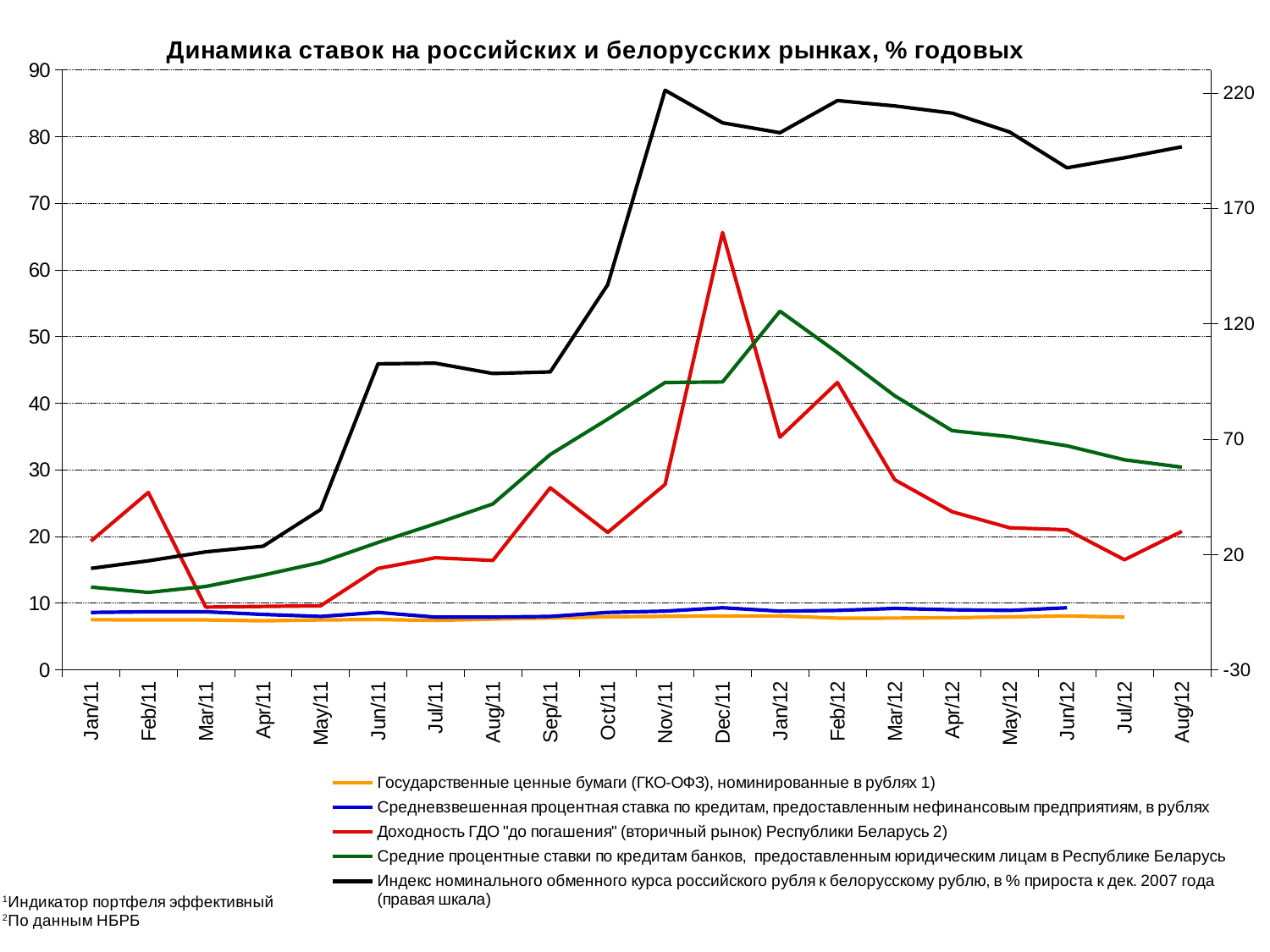
In which month does the red series (Доходность ГДО "до погашения" Республики Беларусь) reach its highest value? Dec/11 In which month does the green series (Средние процентные ставки по кредитам банков в Республике Беларусь) reach its highest value? Jan/12 Is the value of the red series at Dec/11 greater or less than 60? greater Does the green series rise or fall from Jan/12 to Aug/12? fall What kind of chart is shown on the slide? line chart Is the value of the green series at Jan/12 greater or less than 50? greater How many months are shown along the x axis? 20 Is the value of the black series (right scale) at Nov/11 greater or less than 170? greater What is the title of the chart? Динамика ставок на российских и белорусских рынках, % годовых How many series does the legend list? 5 Which series is plotted on the right scale? Индекс номинального обменного курса российского рубля к белорусскому рублю, в % прироста к дек. 2007 года At Aug/12, which is higher: the red series or the green series? the green series